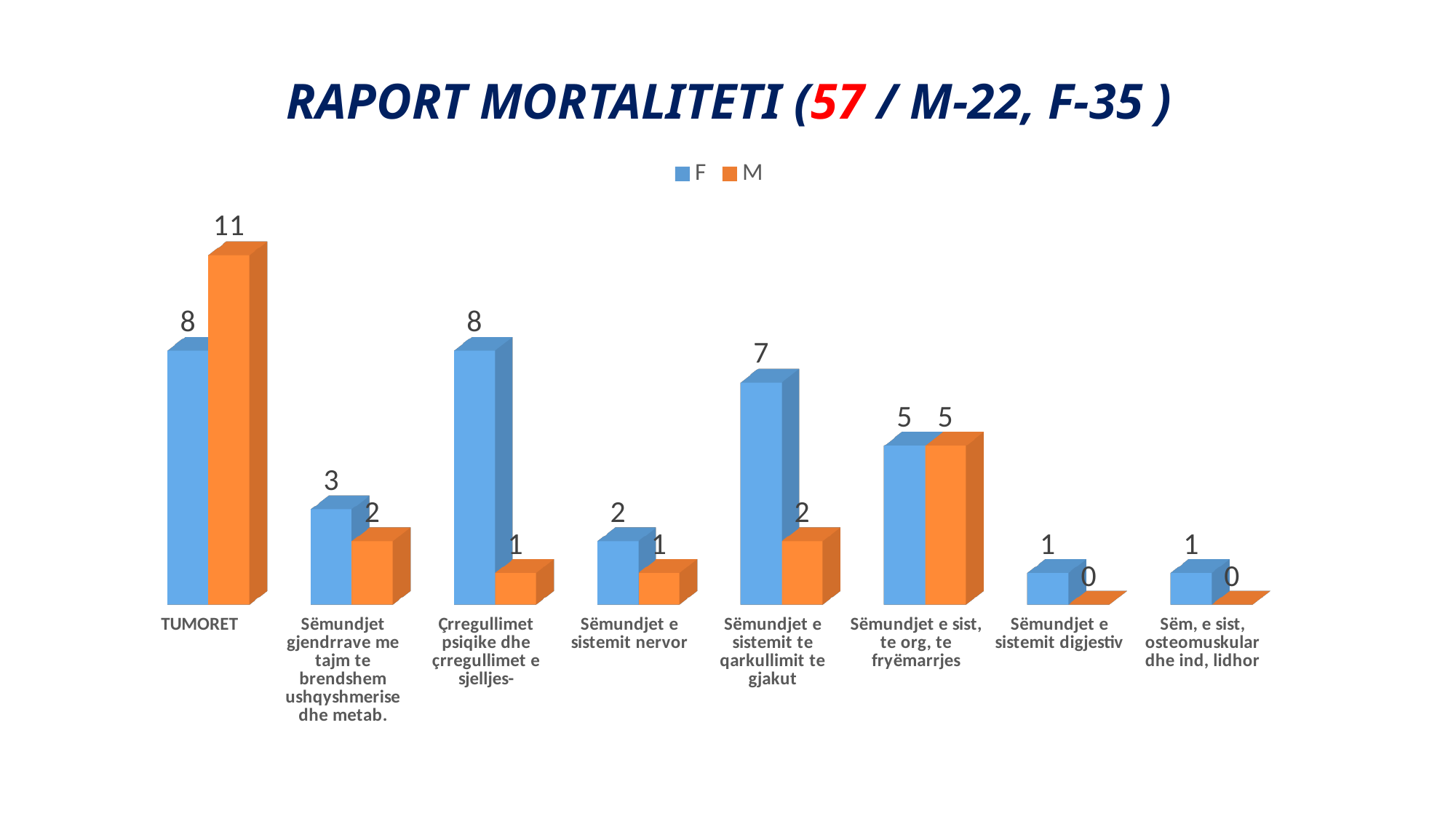
Which category has the highest value for M? TUMORET What is the value for M for Sëmundjet e sistemit digjestiv? 0 How many categories are shown on the x axis? 8 Which is larger for Sëmundjet gjendrrave me tajm te brendshem ushqyshmerise dhe metab., the F value or the M value? F How many series does the legend list? 2 What is the difference between the M and F values for TUMORET? 3 What is the value for M for TUMORET? 11 What kind of chart is shown on the slide? bar chart What is the difference between the F and M values for Çrregullimet psiqike dhe çrregullimet e sjelljes? 7 What is the title of the chart? RAPORT MORTALITETI (57 / M-22, F-35 ) What is the value for F for Çrregullimet psiqike dhe çrregullimet e sjelljes? 8 What is the value for F for Sëmundjet e sistemit te qarkullimit te gjakut? 7